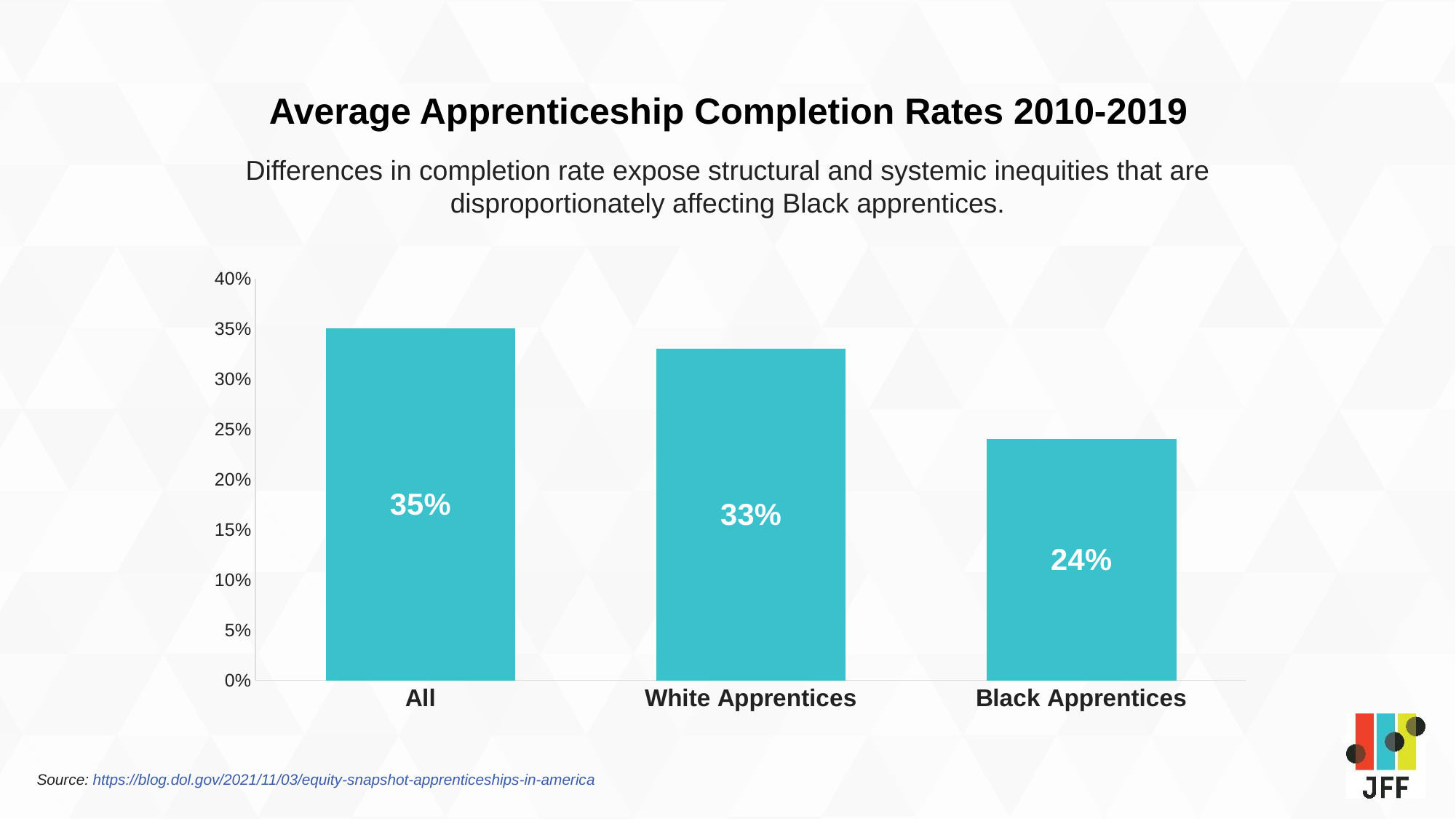
What is the completion rate for White Apprentices? 33% Which category has the lowest completion rate? Black Apprentices Is the completion rate for Black Apprentices greater or less than 25%? less What is the title of the chart? Average Apprenticeship Completion Rates 2010-2019 What is the difference in completion rate between White Apprentices and Black Apprentices? 9% How many categories are shown in the chart? 3 Which has a higher completion rate, White Apprentices or Black Apprentices? White Apprentices What is the difference in completion rate between All and White Apprentices? 2% Which category has the highest completion rate? All What type of chart is shown on the slide? Bar chart What is the completion rate for Black Apprentices? 24% What is the average apprenticeship completion rate for All apprentices? 35%